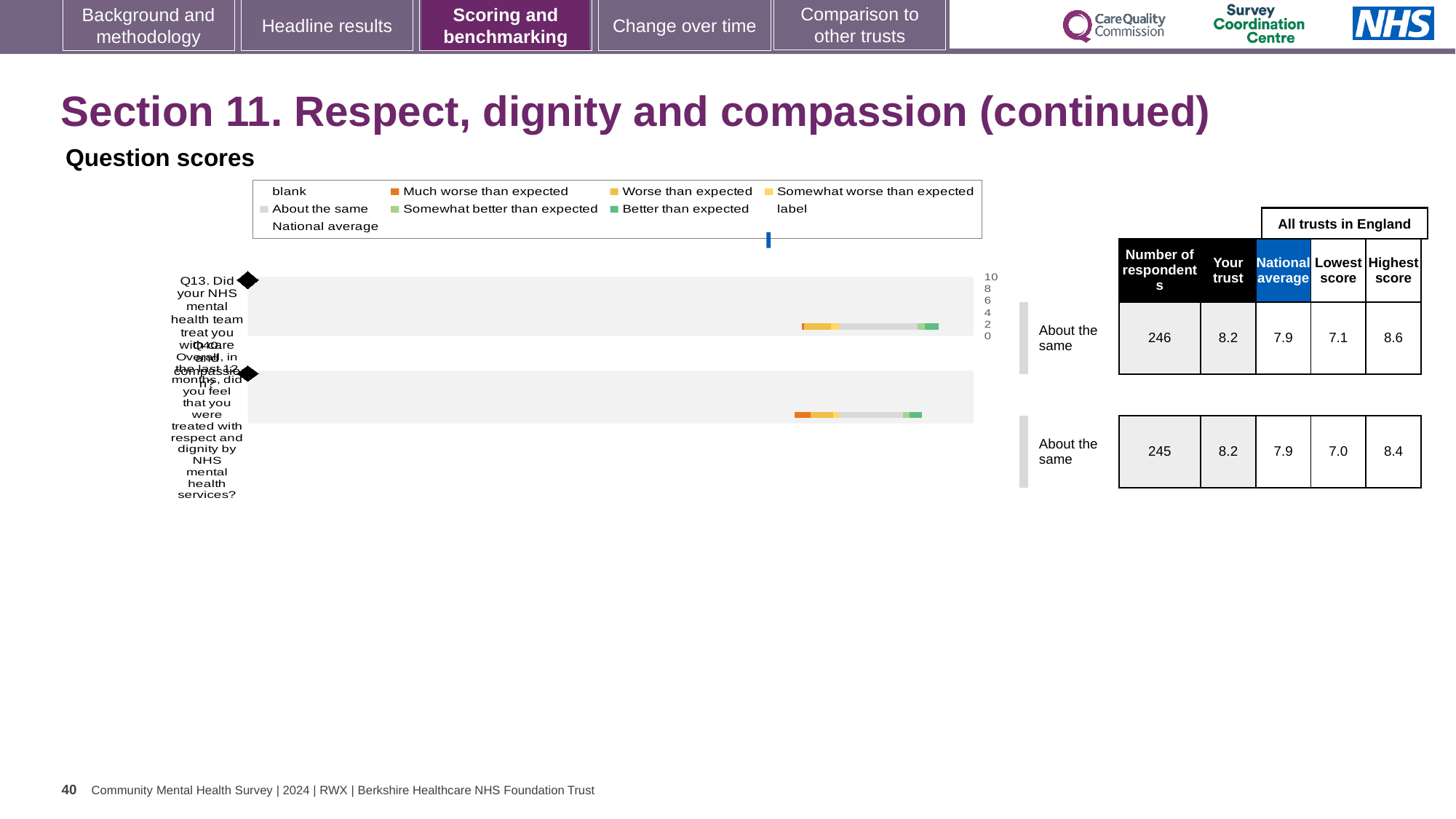
By how much does the trust's score for Q14 exceed the national average? 0.3 What is the 'Your trust' score for Q13 (treated with care and compassion)? 8.2 How many questions are plotted in the question scores chart? 2 What is the lowest score among all trusts in England for Q13? 7.1 Which question has more respondents, Q13 or Q14? Q13 What is the national average score for Q14 (treated with respect and dignity)? 7.9 How many respondents answered Q13? 246 What is the difference between the highest and lowest trust scores for Q13? 1.5 What kind of chart is used to show the question scores on this slide? bar chart What is the highest score among all trusts in England for Q14? 8.4 Which question has the higher 'Highest score' across all trusts in England, Q13 or Q14? Q13 What benchmark category is shown for Q13 in the question scores chart? About the same